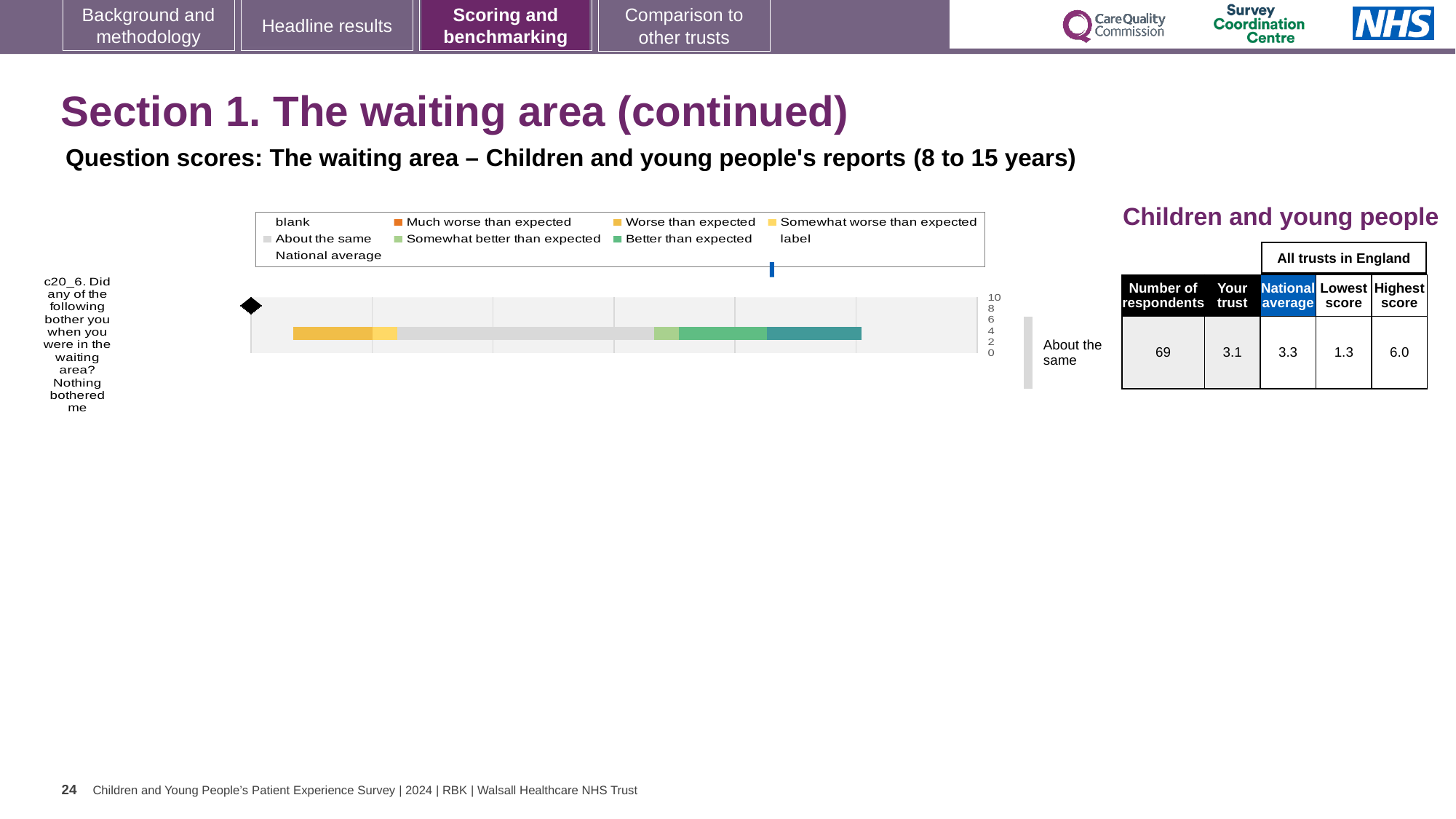
What kind of chart is used to show the benchmarking result for question c20_6? Bar chart Which is larger for question c20_6, the 'Your trust' score or the national average? National average What is the difference between the highest score and the lowest score for question c20_6? 4.7 How many survey questions are plotted on the benchmarking chart? 1 What is the highest score among all trusts in England for question c20_6? 6.0 Is the 'Your trust' score for question c20_6 greater or less than 4 on the chart's axis? less Which benchmarking category is the trust's result for question c20_6 placed in? About the same How many respondents answered question c20_6? 69 What is the 'Your trust' score for question c20_6 (Nothing bothered me in the waiting area)? 3.1 What is the national average score for question c20_6? 3.3 What is the difference between the national average and the 'Your trust' score for question c20_6? 0.2 What is the lowest score among all trusts in England for question c20_6? 1.3